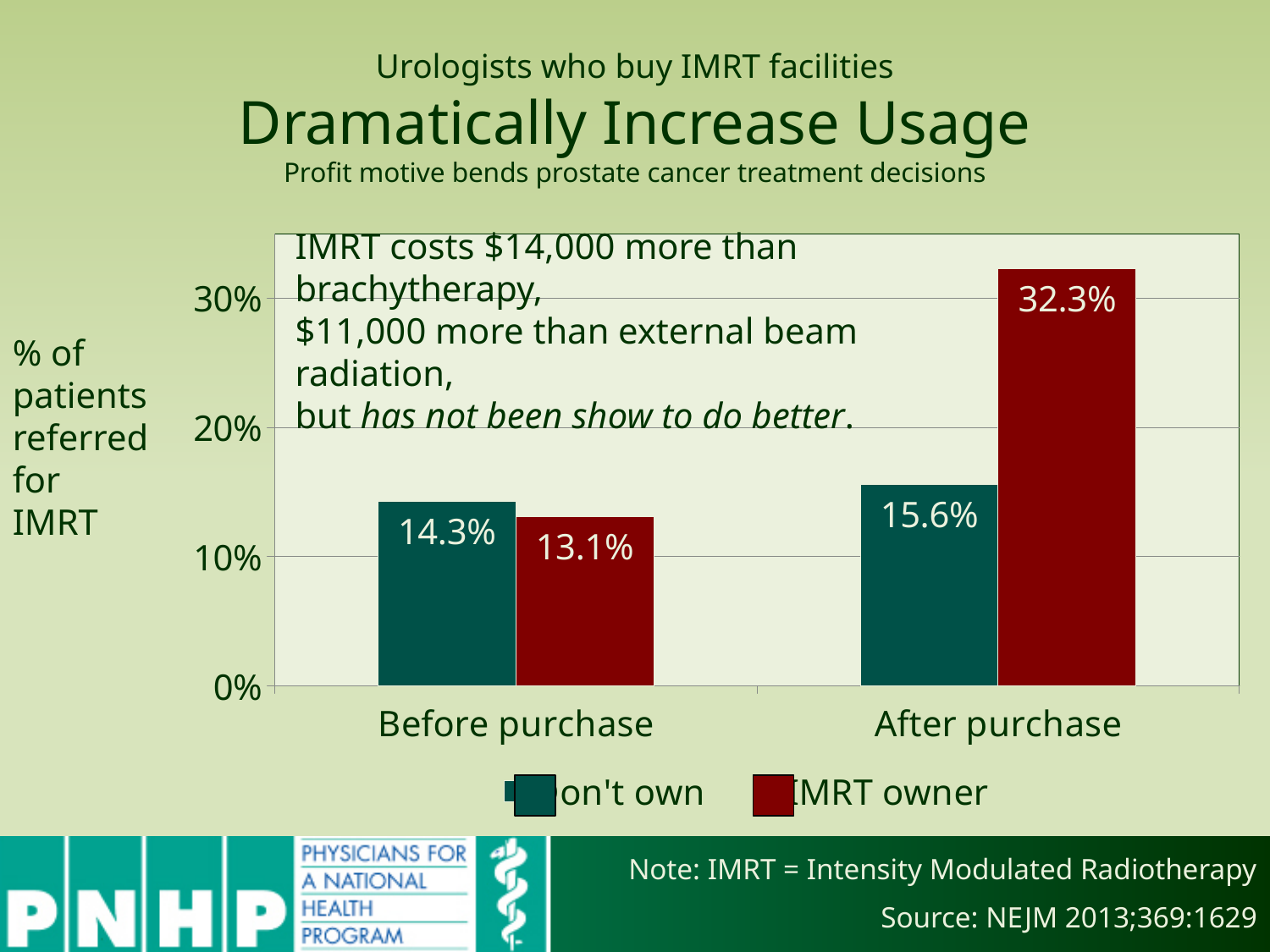
How many series does the legend list? 2 What is the value for IMRT owners before purchase? 13.1% In the After purchase category, which series has the larger value: Don't own or IMRT owner? IMRT owner What percentage of patients were referred for IMRT by IMRT owners after purchase? 32.3% What kind of chart is shown on the slide? Bar chart What is the value for the Don't own series after purchase? 15.6% What is the value for the Don't own series in the Before purchase category? 14.3% How many categories are shown on the x axis? 2 Which bar on the chart has the highest value? IMRT owner, After purchase Which bar on the chart has the lowest value? IMRT owner, Before purchase What is the difference between the IMRT owner values after purchase and before purchase? 19.2% What colour are the IMRT owner bars? Dark red